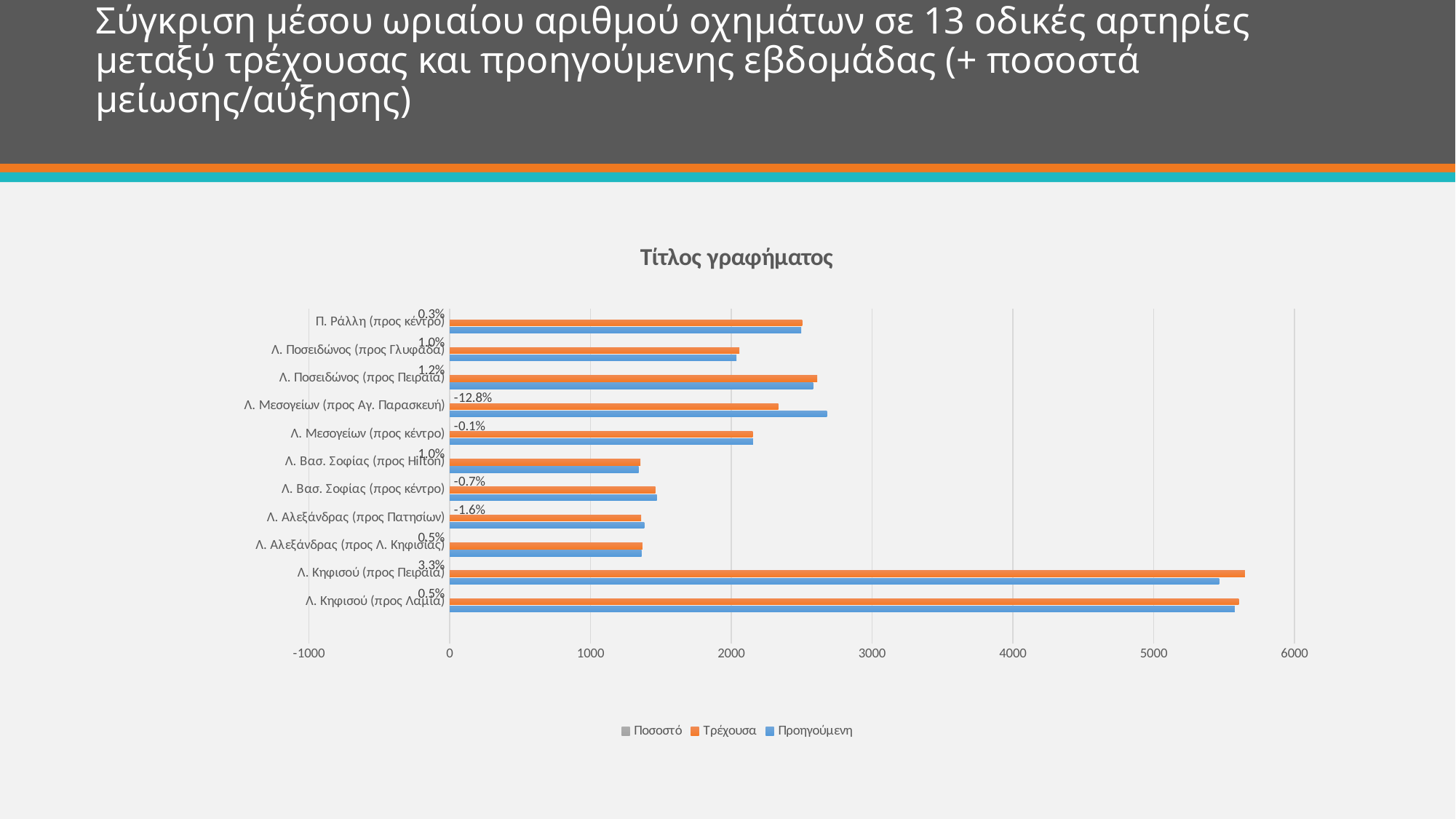
What is the percentage change (Ποσοστό) shown for Λ. Αλεξάνδρας (προς Πατησίων)? -1.6% Which has the larger Τρέχουσα value: Λ. Κηφισού (προς Λαμία) or Λ. Ποσειδώνος (προς Πειραιά)? Λ. Κηφισού (προς Λαμία) Is the Τρέχουσα value for Λ. Κηφισού (προς Πειραιά) greater or less than 5000? greater Which road artery has the lowest percentage change (Ποσοστό)? Λ. Μεσογείων (προς Αγ. Παρασκευή) What kind of chart is shown on the slide? Bar chart What is the percentage change (Ποσοστό) shown for Λ. Κηφισού (προς Πειραιά)? 3.3% How many series does the legend list? 3 Which road artery has the highest percentage change (Ποσοστό)? Λ. Κηφισού (προς Πειραιά) What is the percentage change (Ποσοστό) shown for Π. Ράλλη (προς κέντρο)? 0.3% How many road arteries (categories) are plotted on the chart? 11 What is the percentage change (Ποσοστό) shown for Λ. Μεσογείων (προς Αγ. Παρασκευή)? -12.8% Is the Τρέχουσα value for Λ. Βασ. Σοφίας (προς Hilton) greater or less than 2000? less